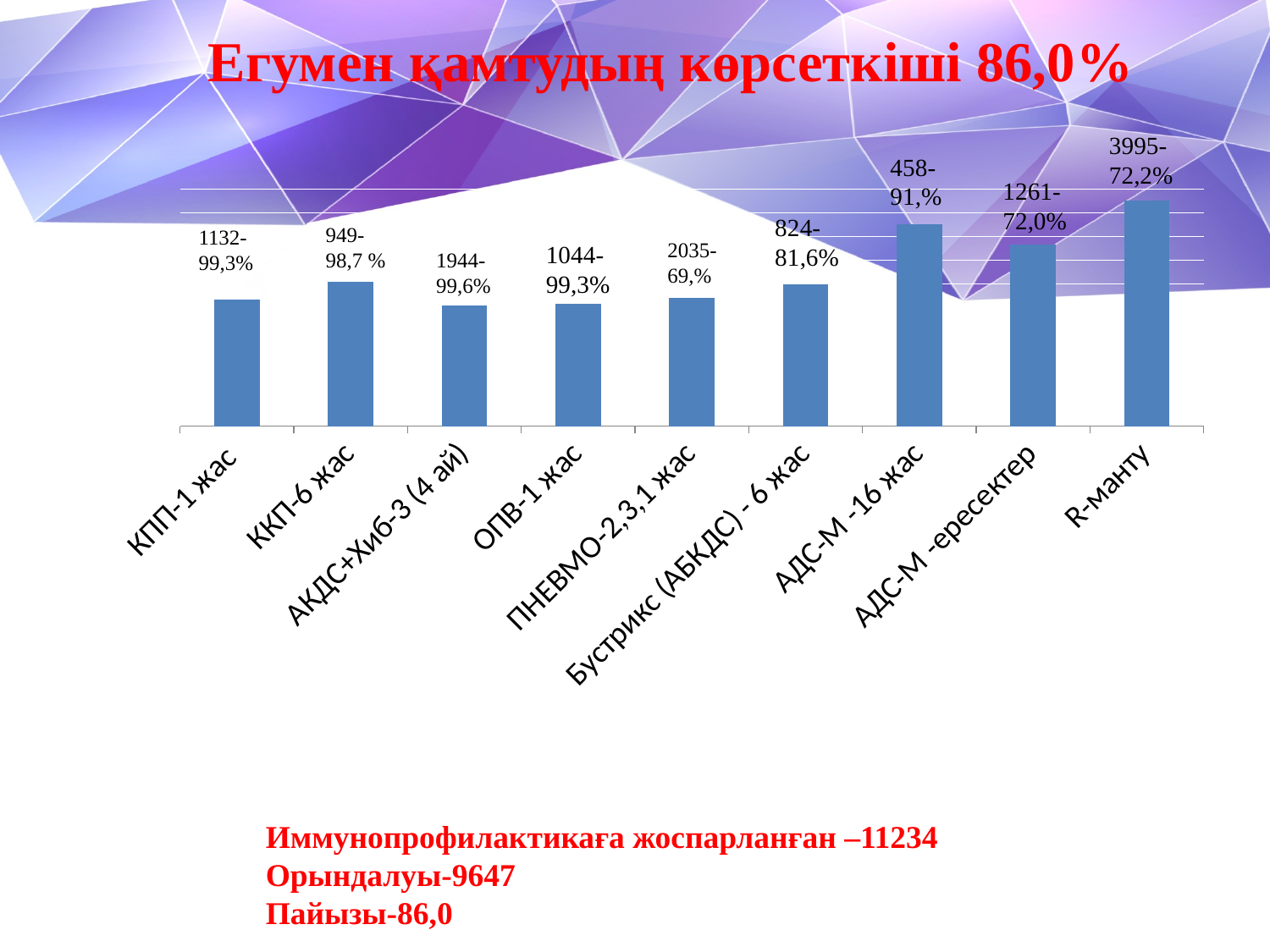
What kind of chart is shown on the slide? Bar chart Which category has the lowest percentage in its data label? ПНЕВМО-2,3,1 жас Which has a higher percentage in its data label, АДС-М -16 жас or АДС-М -ересектер? АДС-М -16 жас What is the data label shown for АДС-М -ересектер? 1261-72,0% What is the data label shown for ОПВ-1 жас? 1044-99,3% Which category has the highest percentage in its data label? АКДС+Хиб-3 (4 ай) What is the data label shown for КПП-1 жас? 1132-99,3% What is the data label shown for R-манту? 3995-72,2% What is the data label shown for АКДС+Хиб-3 (4 ай)? 1944-99,6% How many categories are shown on the x axis of the chart? 9 What is the data label shown for ККП-6 жас? 949-98,7 % What is the data label shown for Бустрикс (АБКДС) - 6 жас? 824-81,6%